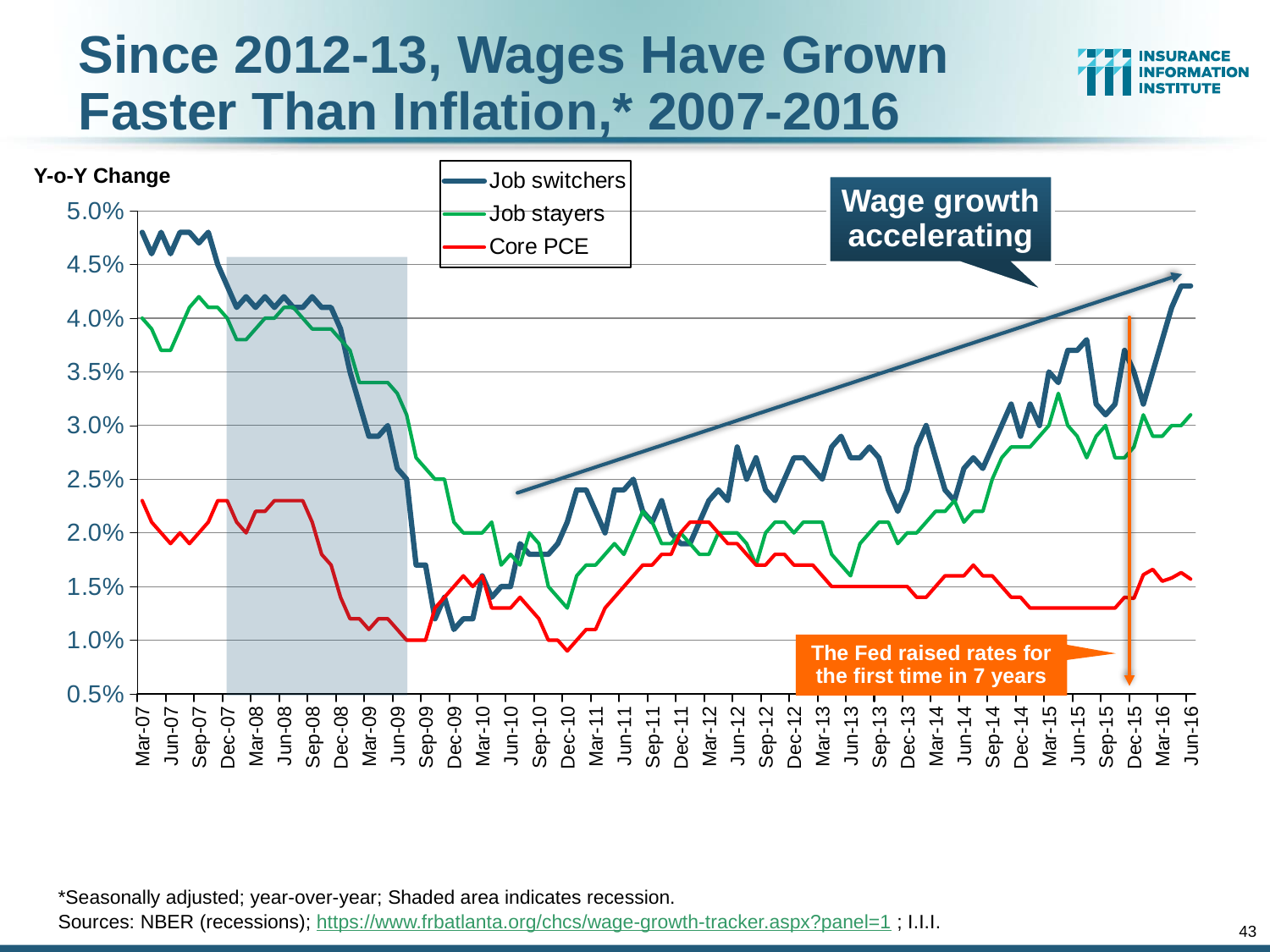
Is the value for Core PCE at Jun-16 greater or less than 2.0%? less How many series does the legend list? 3 Is the value for Job stayers at Jun-16 greater or less than 3.5%? less What are the three series named in the legend? Job switchers, Job stayers, Core PCE At Jun-16, which series has the higher value, Job switchers or Core PCE? Job switchers Is the value for Job switchers at Mar-07 greater or less than 4.5%? greater At Mar-07, which series has the higher value, Job switchers or Job stayers? Job switchers Does the Job switchers series rise or fall between Dec-08 and Sep-09? Fall According to the footnote, what does the shaded area on the chart indicate? Recession What kind of chart is shown on the slide? Line chart